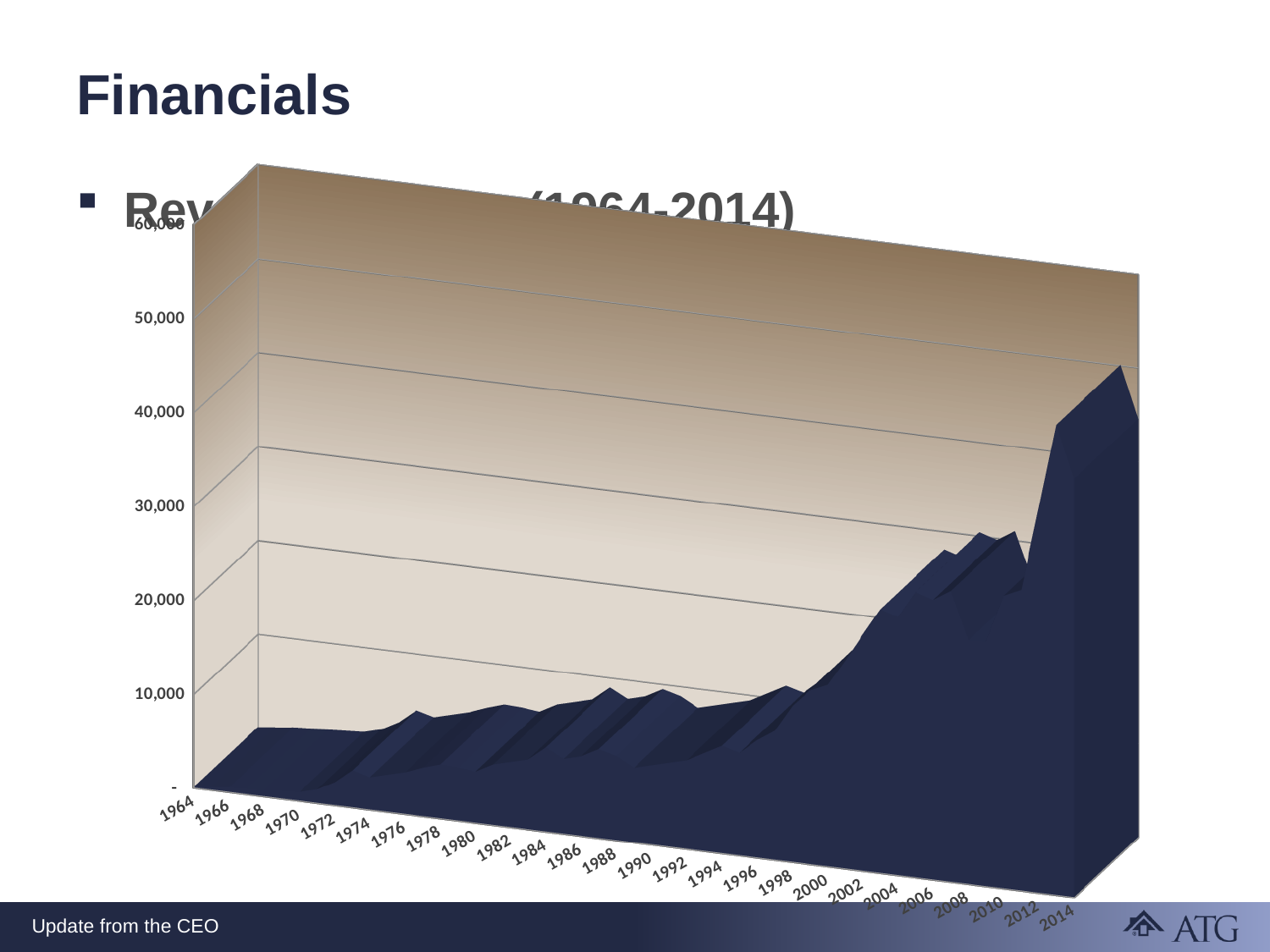
Is the value for 2014 greater or less than 30,000? greater What is the highest value shown on the vertical axis? 60,000 Is the value for 2008 greater or less than 10,000? greater How many year labels are shown on the x axis? 26 Which year has the lowest value on the chart? 1964 Is the value for 2012 greater or less than 30,000? greater Which is larger, the value for 1964 or the value for 2000? 2000 Do the values generally rise or fall from 1964 to 2014? rise Which is larger, the value for 1980 or the value for 2012? 2012 What kind of chart is shown on the slide? area chart